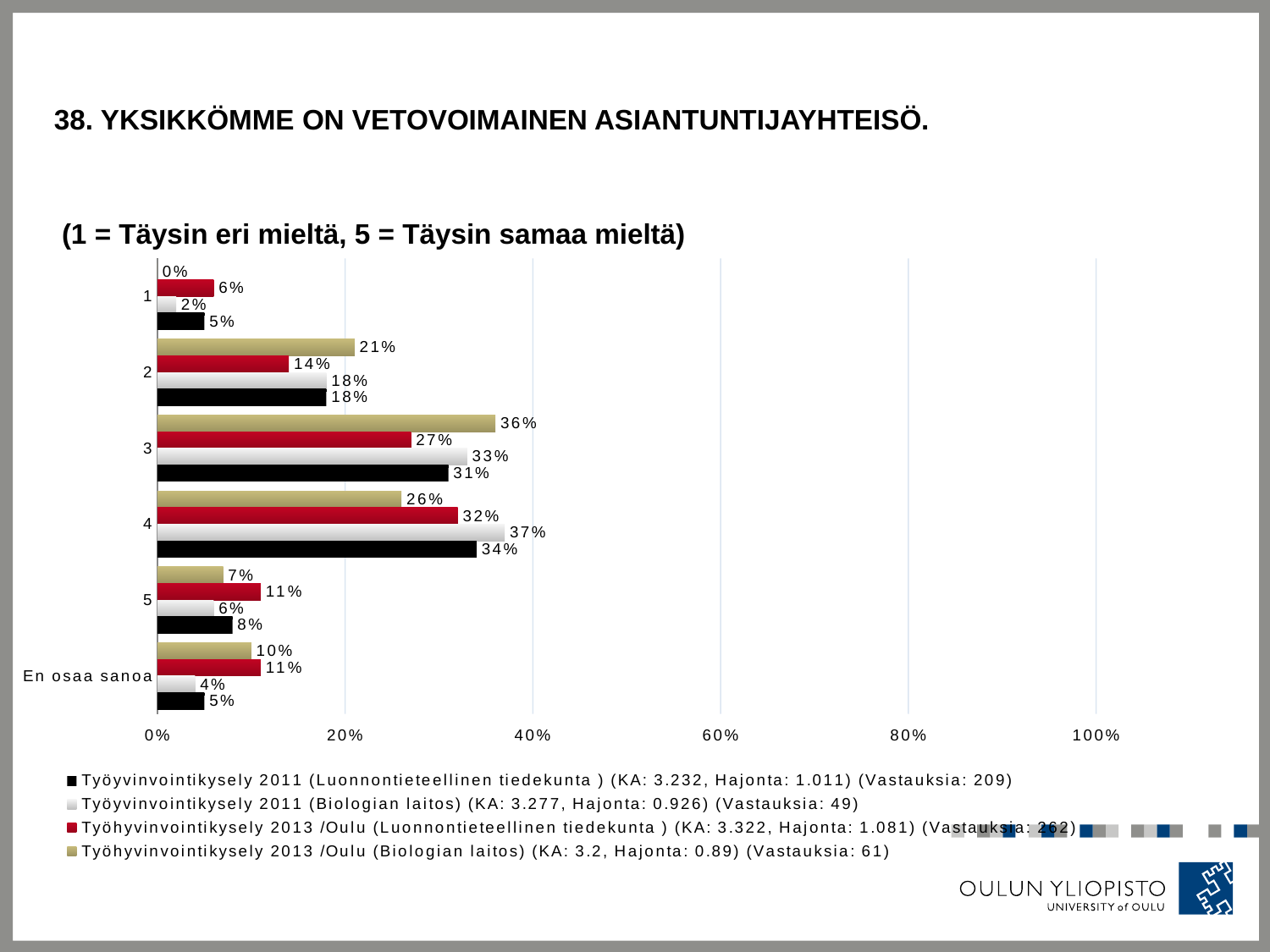
Is the value for category 3 in the Työyvinvointikysely 2011 (Biologian laitos) series greater or less than 20%? greater What kind of chart is shown on the slide? bar chart What is the title of the chart on the slide? 38. YKSIKKÖMME ON VETOVOIMAINEN ASIANTUNTIJAYHTEISÖ. What is the value for category 3 in the Työhyvinvointikysely 2013 /Oulu (Biologian laitos) series? 36% What is the value for 'En osaa sanoa' in the Työhyvinvointikysely 2013 /Oulu (Luonnontieteellinen tiedekunta) series? 11% What is the value for category 4 in the Työyvinvointikysely 2011 (Biologian laitos) series? 37% How many categories are shown on the vertical axis? 6 How many series does the legend list? 4 Which category has the highest value in the Työyvinvointikysely 2011 (Luonnontieteellinen tiedekunta) series? 4 For category 4, which series has the larger value: Työhyvinvointikysely 2013 /Oulu (Biologian laitos) or Työhyvinvointikysely 2013 /Oulu (Luonnontieteellinen tiedekunta)? Työhyvinvointikysely 2013 /Oulu (Luonnontieteellinen tiedekunta) Which category has the lowest value in the Työhyvinvointikysely 2013 /Oulu (Biologian laitos) series? 1 What is the difference between the Työyvinvointikysely 2011 (Biologian laitos) value and the Työhyvinvointikysely 2013 /Oulu (Luonnontieteellinen tiedekunta) value for category 2? 4%